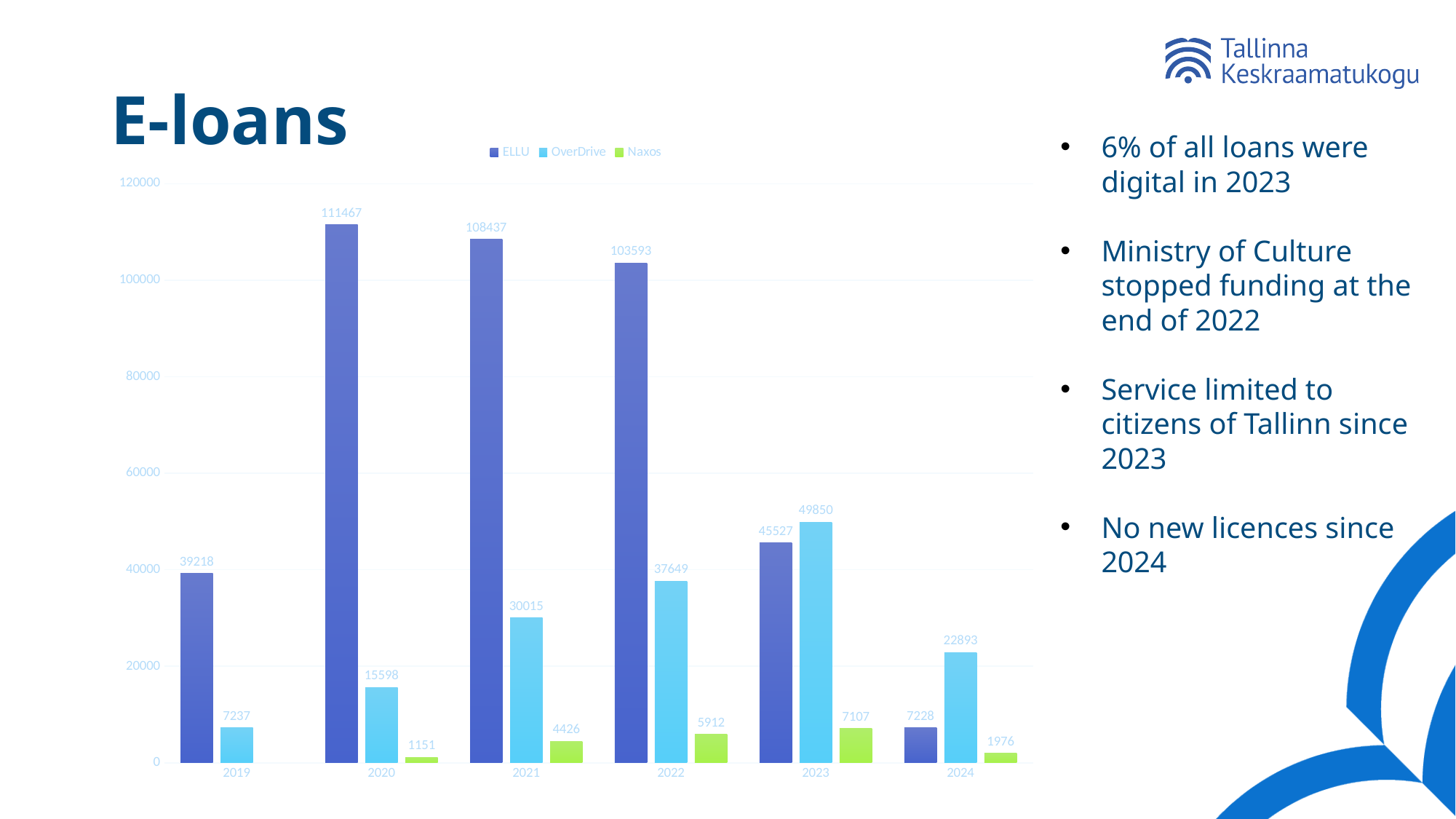
What is the ELLU value for 2020? 111467 Is the ELLU value for 2022 greater or less than 100000? greater Which is larger in 2023, the ELLU value or the OverDrive value? OverDrive What kind of chart is shown on the slide? Bar chart How many years are shown on the x axis? 6 What is the OverDrive value for 2023? 49850 How many series does the legend list? 3 In which year is the OverDrive value lowest? 2019 What is the Naxos value for 2022? 5912 Does the OverDrive value rise or fall from 2019 to 2023? Rise In which year is the ELLU value highest? 2020 What is the difference between the ELLU value in 2020 and the ELLU value in 2021? 3030